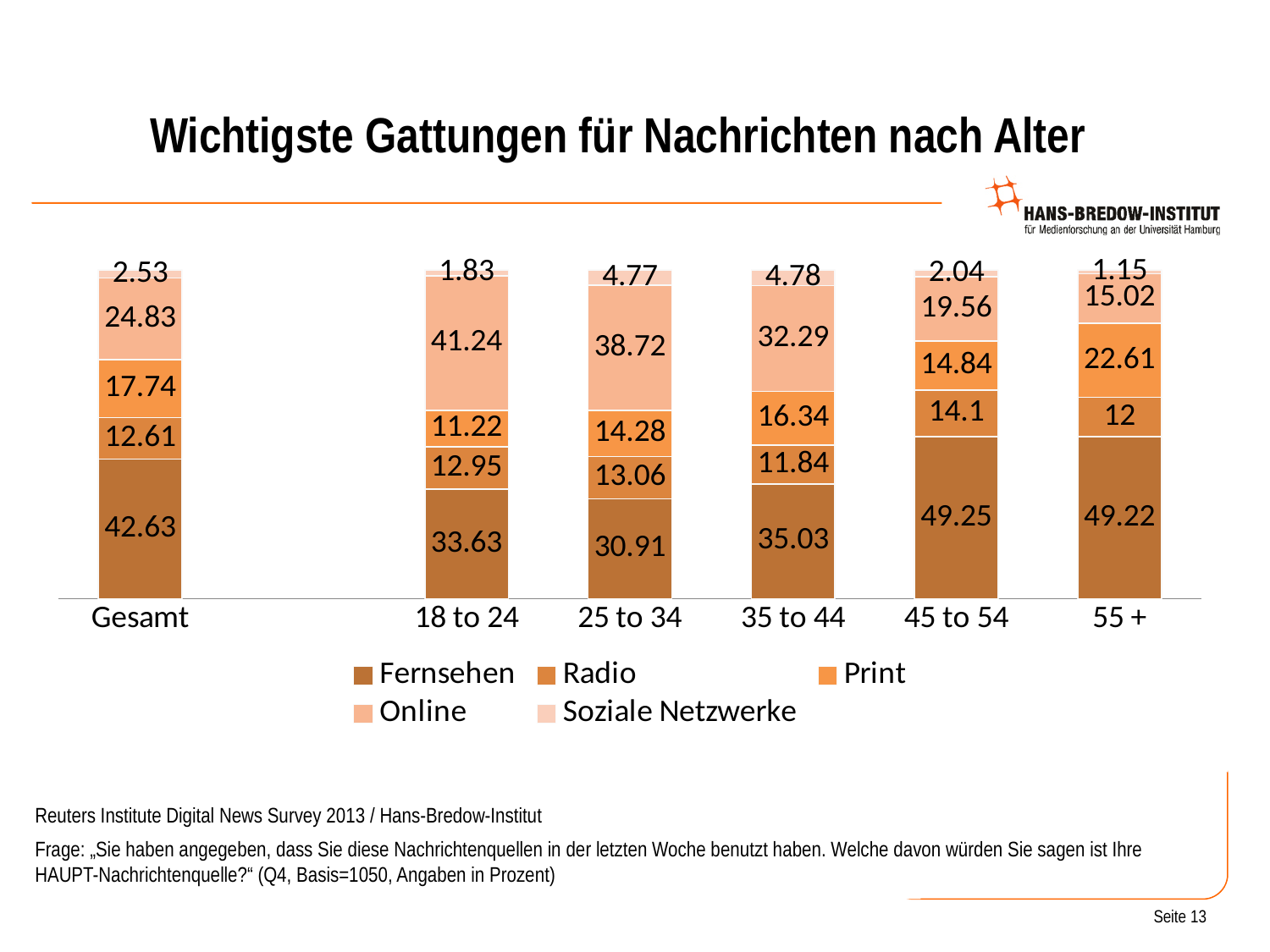
Which category has the lowest Soziale Netzwerke value? 55 + How many series does the legend list? 5 What is the Print value for the 55 + age group? 22.61 How many categories are shown on the x axis? 6 What kind of chart is shown on the slide? Stacked bar chart Is the Print value larger for 55 + or for 18 to 24? 55 + What is the difference between the Online value for 18 to 24 and the Online value for 55 +? 26.22 What is the Soziale Netzwerke value for the 45 to 54 age group? 2.04 Which age group has the highest Online value? 18 to 24 What is the Online value for the 18 to 24 age group? 41.24 What is the Fernsehen value for the Gesamt category? 42.63 Which category has the lowest Fernsehen value? 25 to 34